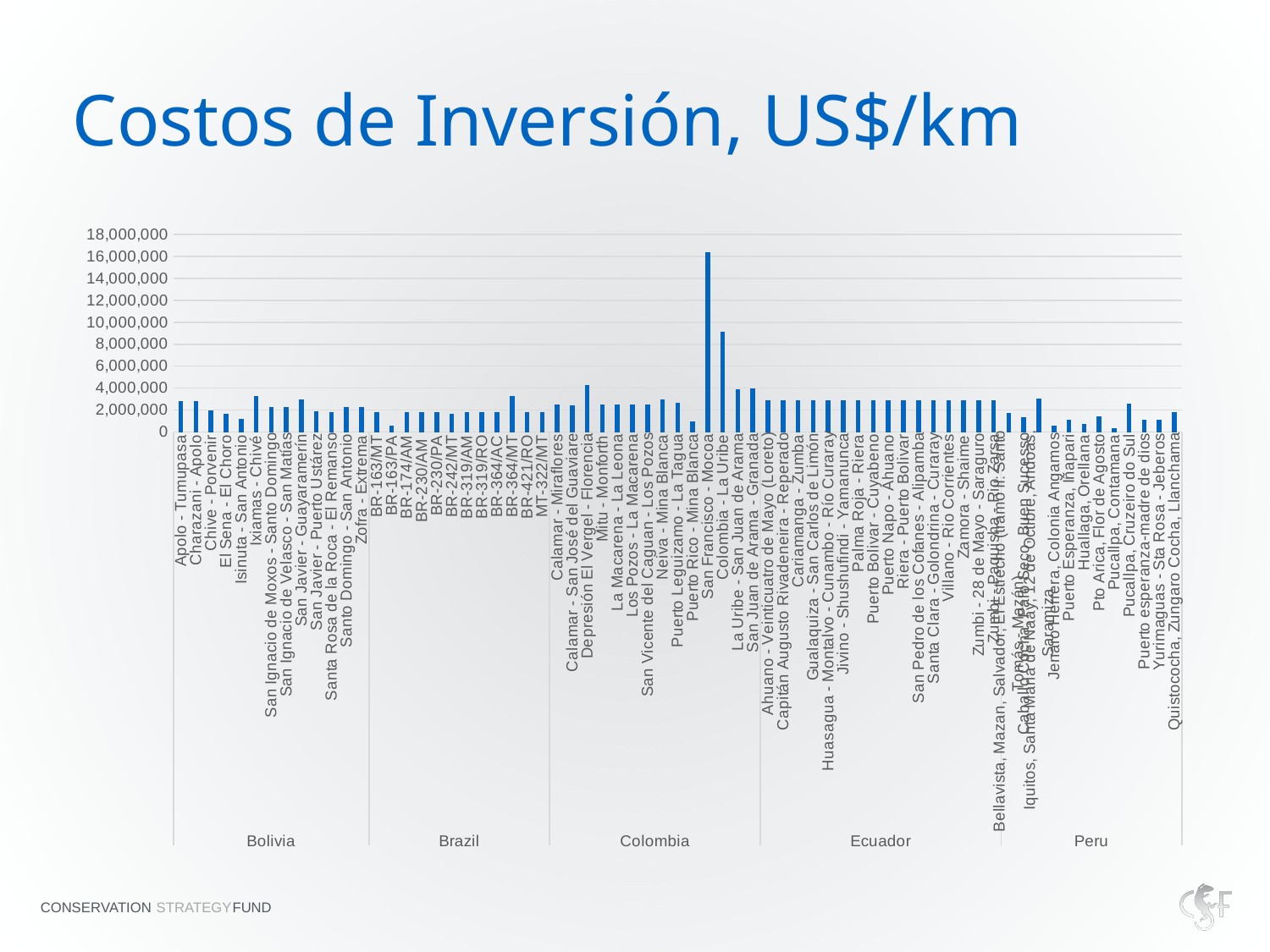
Which is larger, the value for Colombia - La Uribe or the value for Zamora - Shaime? Colombia - La Uribe Is the value for San Francisco - Mocoa greater or less than 14,000,000? greater Is the value for Ixiamas - Chivé greater or less than 2,000,000? greater What kind of chart is shown on the slide? bar chart What is the title of the chart? Costos de Inversión, US$/km Which is larger, the value for Depresión El Vergel - Florencia or the value for BR-163/PA? Depresión El Vergel - Florencia How many country groups are labelled along the x axis of the chart? 5 Which country group contains the highest bar in the chart? Colombia Which category has the highest bar in the chart? San Francisco - Mocoa Which is larger, the value for San Francisco - Mocoa or the value for Colombia - La Uribe? San Francisco - Mocoa Is the value for BR-163/PA greater or less than 2,000,000? less